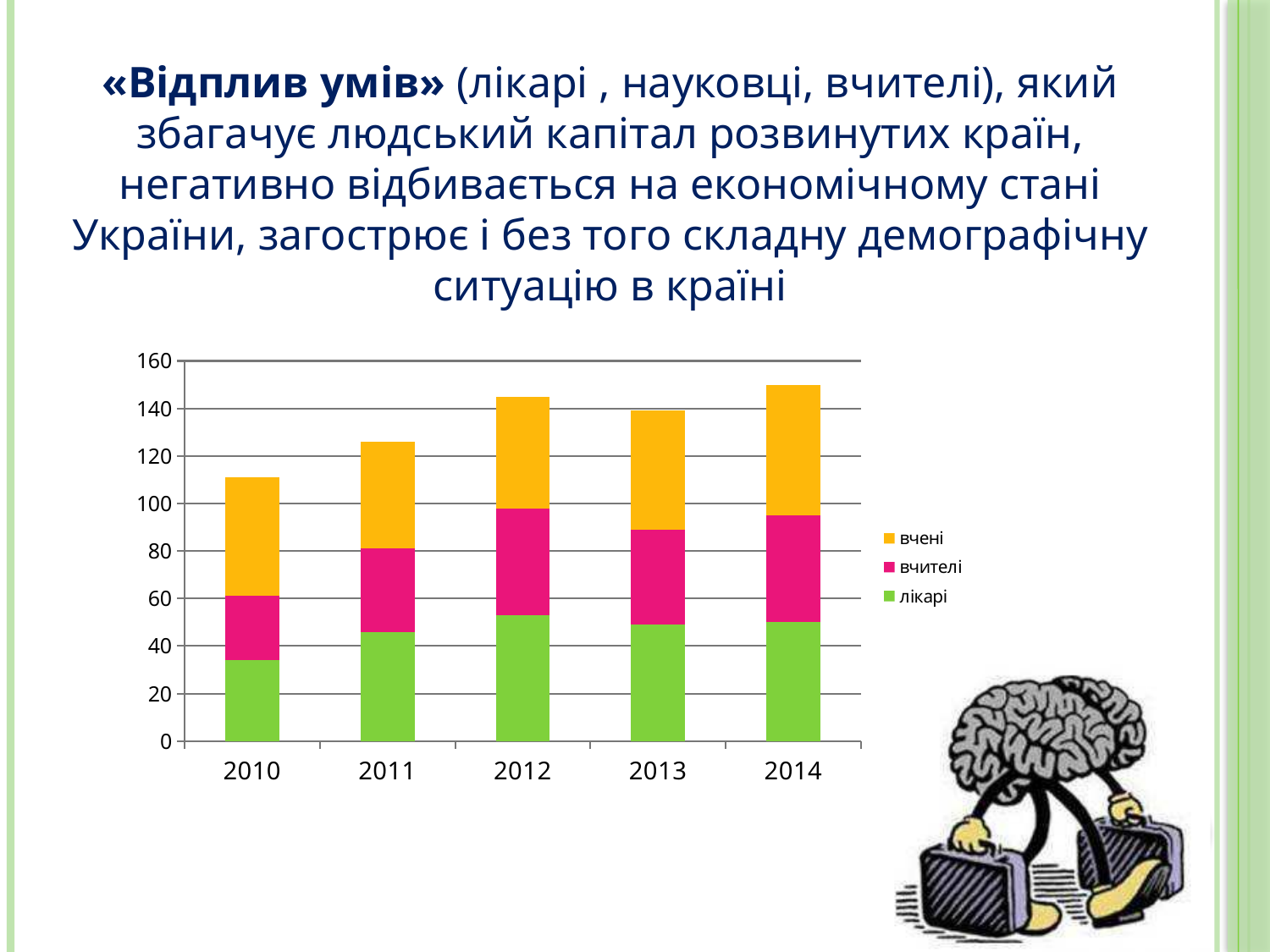
How many years (categories) are shown on the x axis of the chart? 5 How many series does the chart's legend list? 3 Is the value for лікарі in 2012 greater or less than 40? greater Which is larger: the total bar for 2010 or the total bar for 2014? 2014 What kind of chart is shown on the slide? stacked bar chart Which series is shown at the bottom of each stacked bar? лікарі Is the total bar height for 2011 greater or less than 120? greater Do the total bar heights generally rise or fall from 2010 to 2014? rise Which year has the lowest total bar height in the chart? 2010 Is the value for лікарі in 2010 greater or less than 40? less